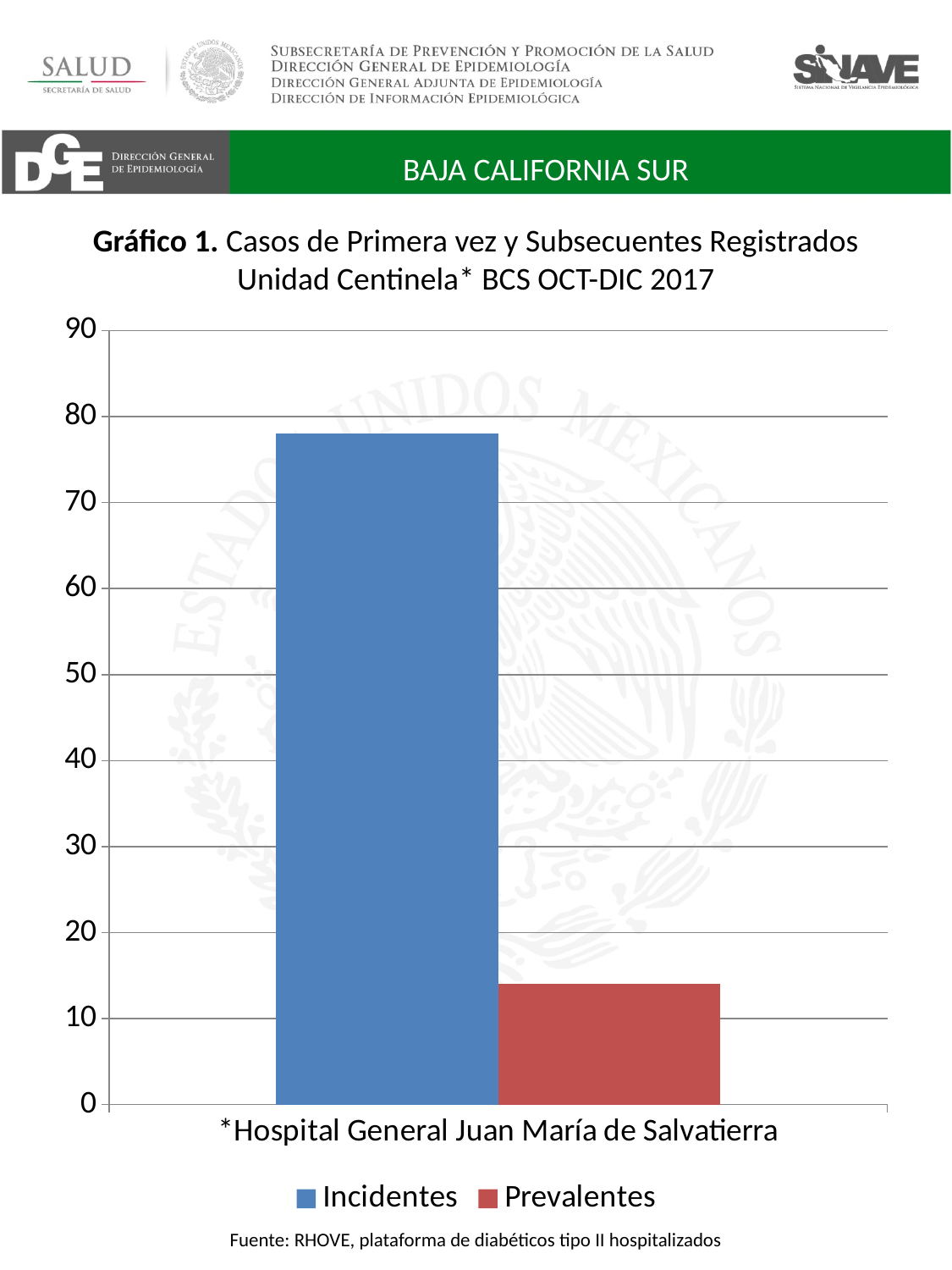
What kind of chart is shown on the slide? bar chart Which series has the lowest value? Prevalentes Is the value for Incidentes greater or less than 70? greater How many series does the legend list? 2 Is the value for Prevalentes greater or less than 10? greater Which series has the highest value? Incidentes How many categories are shown on the x axis? 1 Is the value for Incidentes greater or less than 80? less What colour is the bar for Prevalentes? red What is the category label shown on the x axis? *Hospital General Juan María de Salvatierra Which series has the higher value, Incidentes or Prevalentes? Incidentes